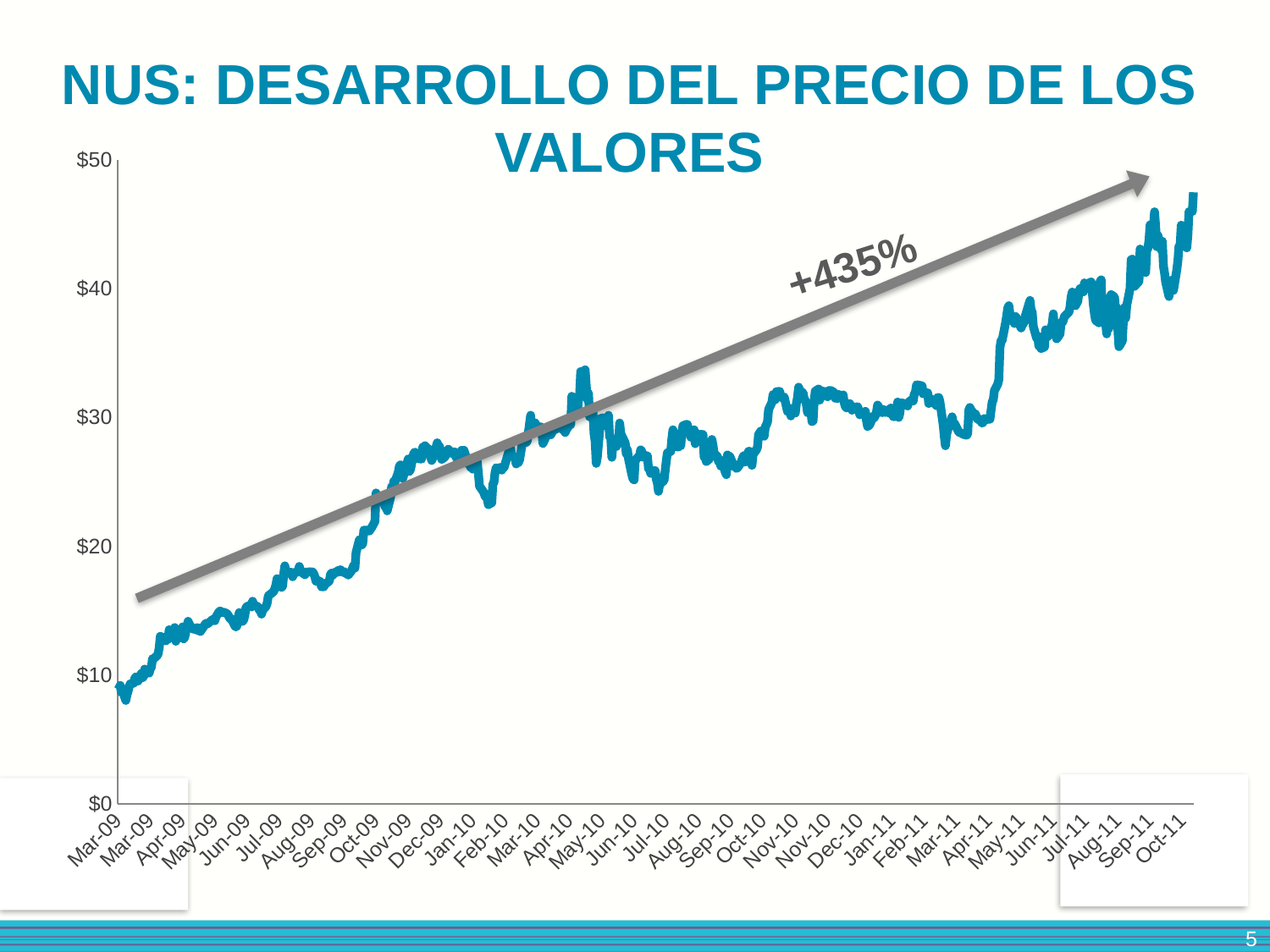
Is the share price around Jan-10 greater or less than $20? greater Which is larger, the share price in Oct-11 or the share price in Mar-09? Oct-11 Is the share price around Jun-11 greater or less than $30? greater Is the share price at the start of the chart (Mar-09) greater or less than $10? less What is the title of the chart on the slide? NUS: DESARROLLO DEL PRECIO DE LOS VALORES Overall, does the share price rise or fall from Mar-09 to Oct-11? rise Around which month on the x axis does the share price reach its highest level? Oct-11 What is the highest value shown on the y axis? $50 What kind of chart is shown on the slide? line chart What percentage change is annotated next to the arrow on the chart? +435%